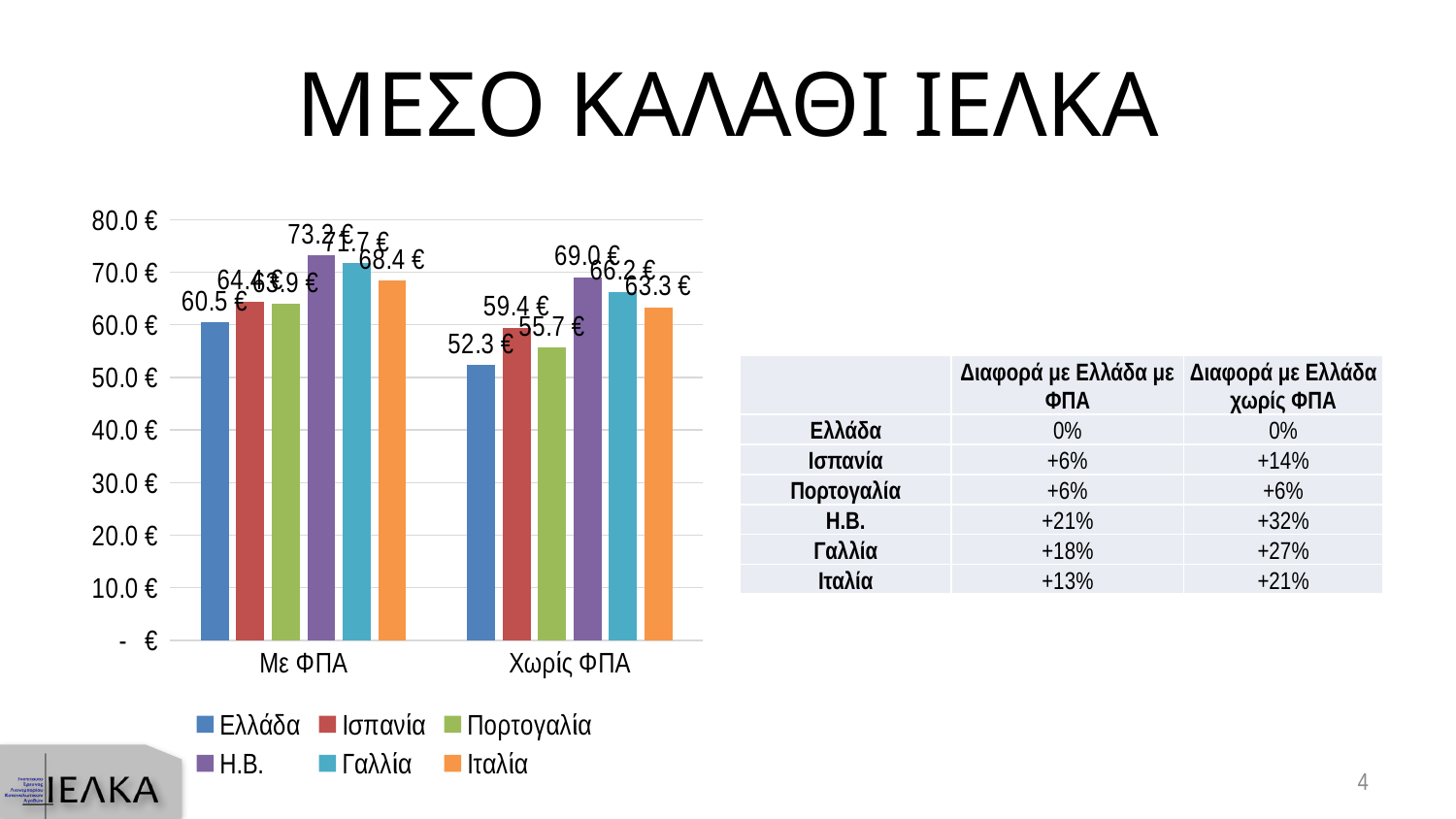
Which country has the highest value in the Με ΦΠΑ group? Η.Β. What is the value for Γαλλία in the Χωρίς ΦΠΑ group? 66.2 € How many series does the legend list? 6 What is the value for Ελλάδα in the Με ΦΠΑ group? 60.5 € What is the difference between Η.Β. and Ελλάδα in the Με ΦΠΑ group? 12.7 € What is the value for Η.Β. in the Με ΦΠΑ group? 73.2 € What is the value for Ιταλία in the Χωρίς ΦΠΑ group? 63.3 € In the Χωρίς ΦΠΑ group, which is larger: Γαλλία or Ιταλία? Γαλλία What is the value for Ελλάδα in the Χωρίς ΦΠΑ group? 52.3 € How many categories are shown on the x axis? 2 What kind of chart is shown on the slide? bar chart Which country has the lowest value in the Χωρίς ΦΠΑ group? Ελλάδα